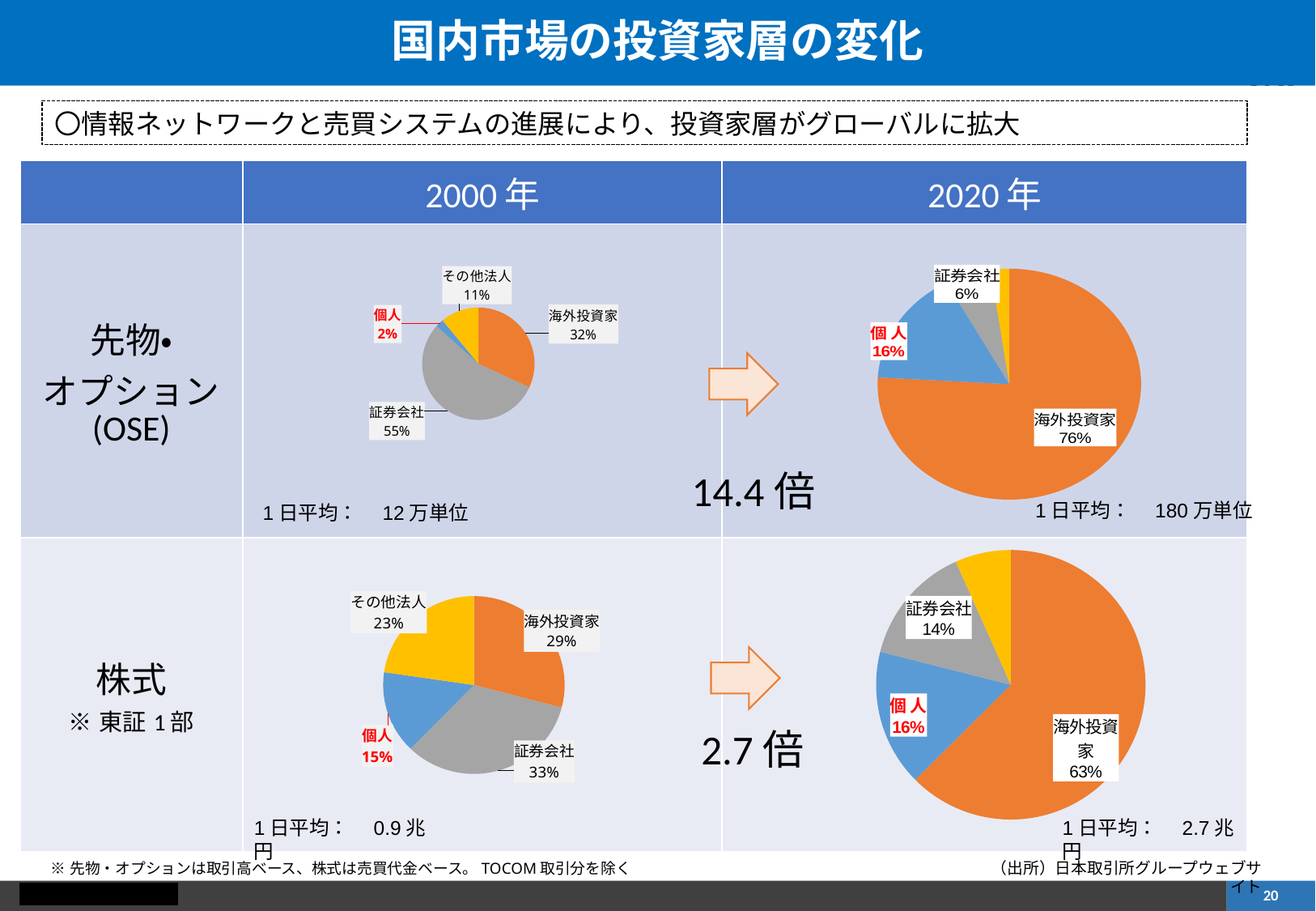
What is the difference between the 海外投資家 share in the 先物・オプション (OSE) 2020年 pie chart and in the 2000年 pie chart? 44 percentage points What type of chart is used to show the investor composition on this slide? Pie chart In the 先物・オプション (OSE) 2000年 pie chart, which labelled category has the smallest share? 個人 In the 先物・オプション (OSE) 2000年 pie chart, what share is 証券会社? 55% In the 株式 2020年 pie chart, what share is 証券会社? 14% In the 先物・オプション (OSE) 2000年 pie chart, which category has the largest share? 証券会社 In the 先物・オプション (OSE) 2020年 pie chart, what share is 海外投資家? 76% In the 株式 2000年 pie chart, what share is その他法人? 23% In the 株式 2000年 pie chart, which category has the largest share? 証券会社 In the 株式 2000年 pie chart, which is larger, the share of 海外投資家 or the share of 証券会社? 証券会社 How many pie charts are shown on the slide? 4 In the 株式 2020年 pie chart, which category has the largest share? 海外投資家